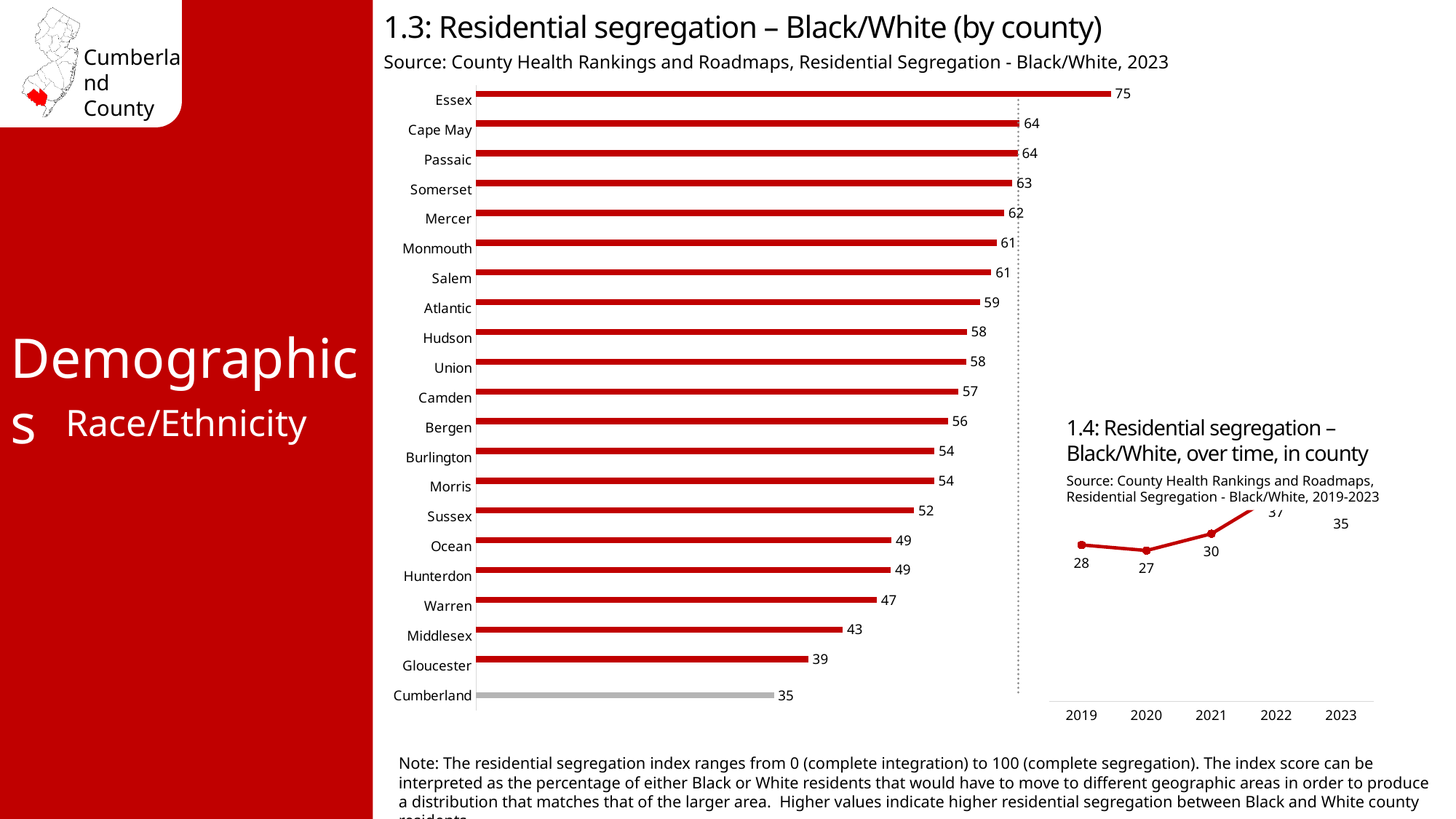
In chart 1.3 (Residential segregation – Black/White by county), what is the value for Essex? 75 In chart 1.4 (Residential segregation – Black/White over time), what is the value for 2020? 27 In chart 1.3 (by county), what is the value for Cumberland? 35 In chart 1.3 (by county), which has a higher value, Gloucester or Warren? Warren In chart 1.3 (by county), what is the difference between the values for Essex and Cumberland? 40 In chart 1.3 (by county), which county has the highest residential segregation index? Essex What kind of chart is chart 1.3 (Residential segregation – Black/White by county)? Bar chart In chart 1.3 (by county), what is the value for Middlesex? 43 In chart 1.3 (by county), how many counties are shown? 21 In chart 1.3 (by county), which county has the lowest residential segregation index? Cumberland In chart 1.4 (over time), how many years are shown on the x axis? 5 In chart 1.4 (over time), what is the value for 2023? 35